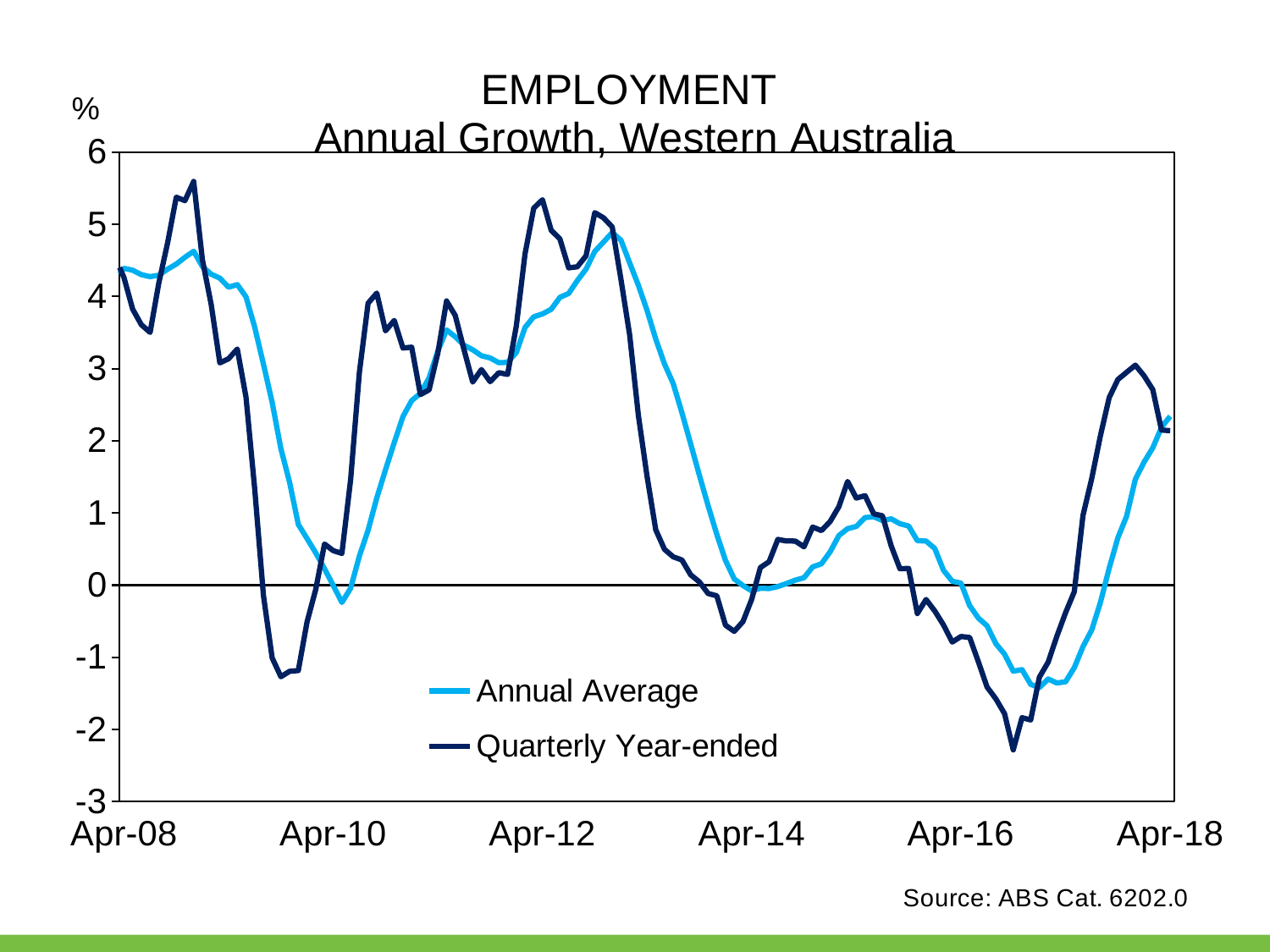
Which series reaches the highest peak on the chart? Quarterly Year-ended What is the title of the chart? EMPLOYMENT Annual Growth, Western Australia What source is cited below the chart? ABS Cat. 6202.0 Does the Annual Average series rise or fall between Apr-16 and Apr-18? rise Is the Quarterly Year-ended value at Apr-16 greater or less than 0? less Is the Quarterly Year-ended value at Apr-18 greater or less than 1? greater What kind of chart is shown on the slide? line chart Is the Annual Average value at Apr-12 greater or less than 3? greater At Apr-12, which series has the higher value, Annual Average or Quarterly Year-ended? Quarterly Year-ended How many series does the legend list? 2 Which series reaches the lowest point on the chart? Quarterly Year-ended